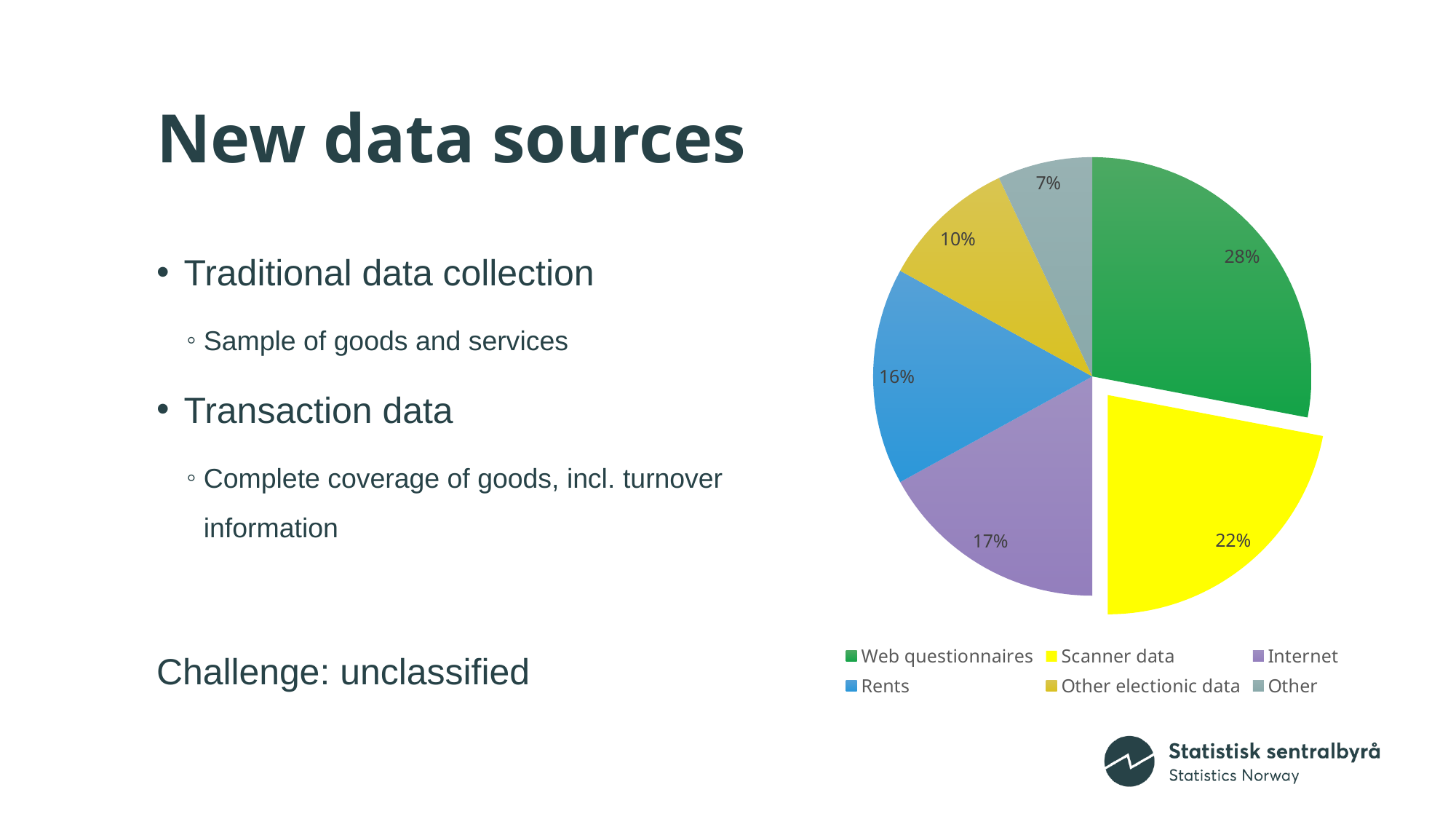
What share of the pie does Rents have? 16% How many slices does the pie chart have? 6 What share of the pie does Scanner data have? 22% Which category has the largest slice of the pie? Web questionnaires What share of the pie does Internet have? 17% What share of the pie does Web questionnaires have? 28% What is the difference in percentage points between Web questionnaires and Scanner data? 6 What share of the pie does Other electionic data have? 10% Which category has the smallest slice of the pie? Other What kind of chart is shown on the slide? Pie chart Which slice is pulled out (exploded) from the pie? Scanner data Which is larger, the slice for Internet or the slice for Other electionic data? Internet